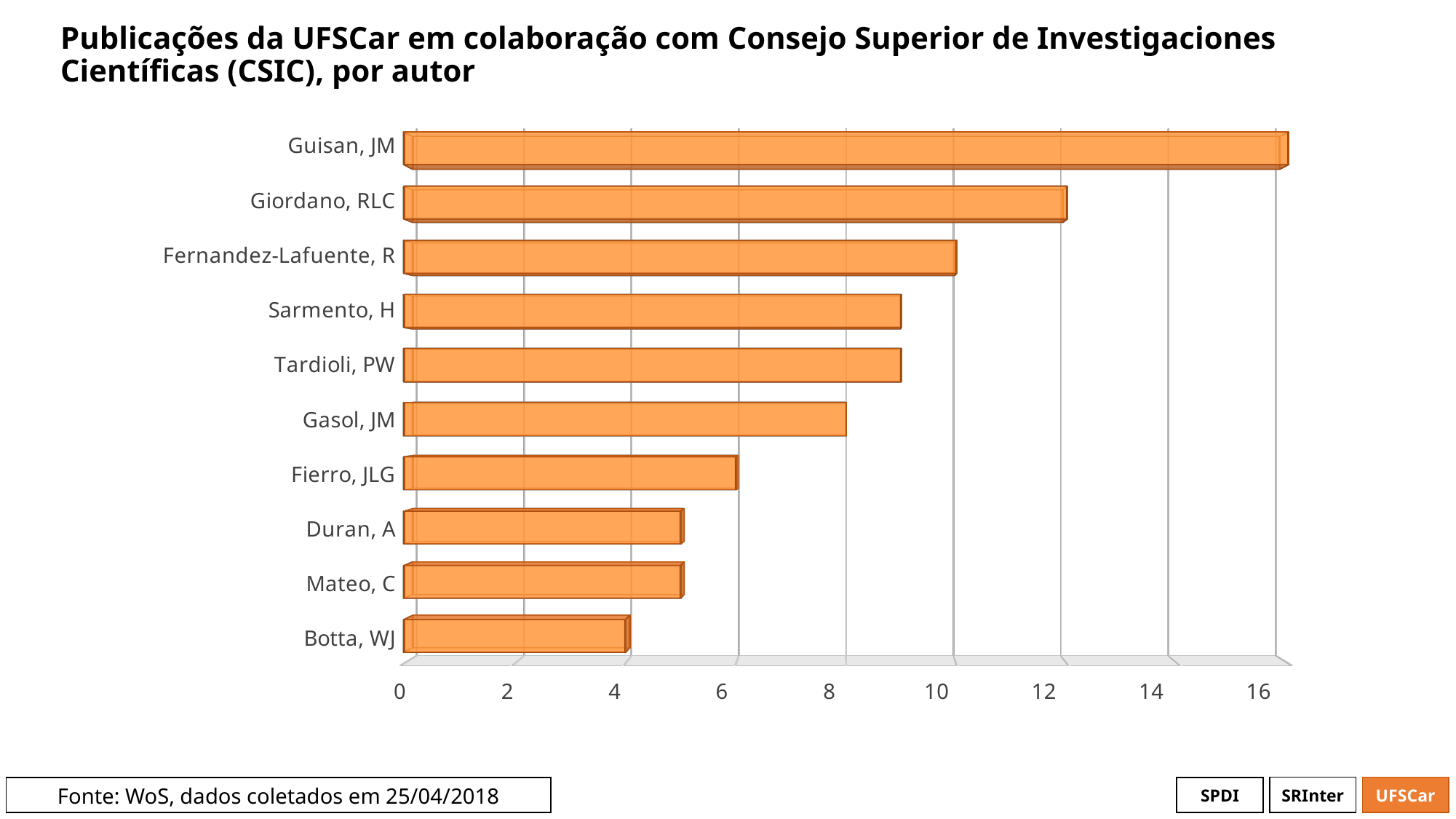
Is the value for Gasol, JM greater or less than 10? less Which has more publications, Fierro, JLG or Gasol, JM? Gasol, JM Which has more publications, Giordano, RLC or Fernandez-Lafuente, R? Giordano, RLC Is the value for Giordano, RLC greater or less than 10? greater Which author has the lowest number of publications? Botta, WJ How many authors are listed on the chart? 10 Is the value for Botta, WJ greater or less than 6? less What is the data source cited at the bottom of the slide? WoS, dados coletados em 25/04/2018 What kind of chart is shown on the slide? bar chart Which author has the highest number of publications? Guisan, JM